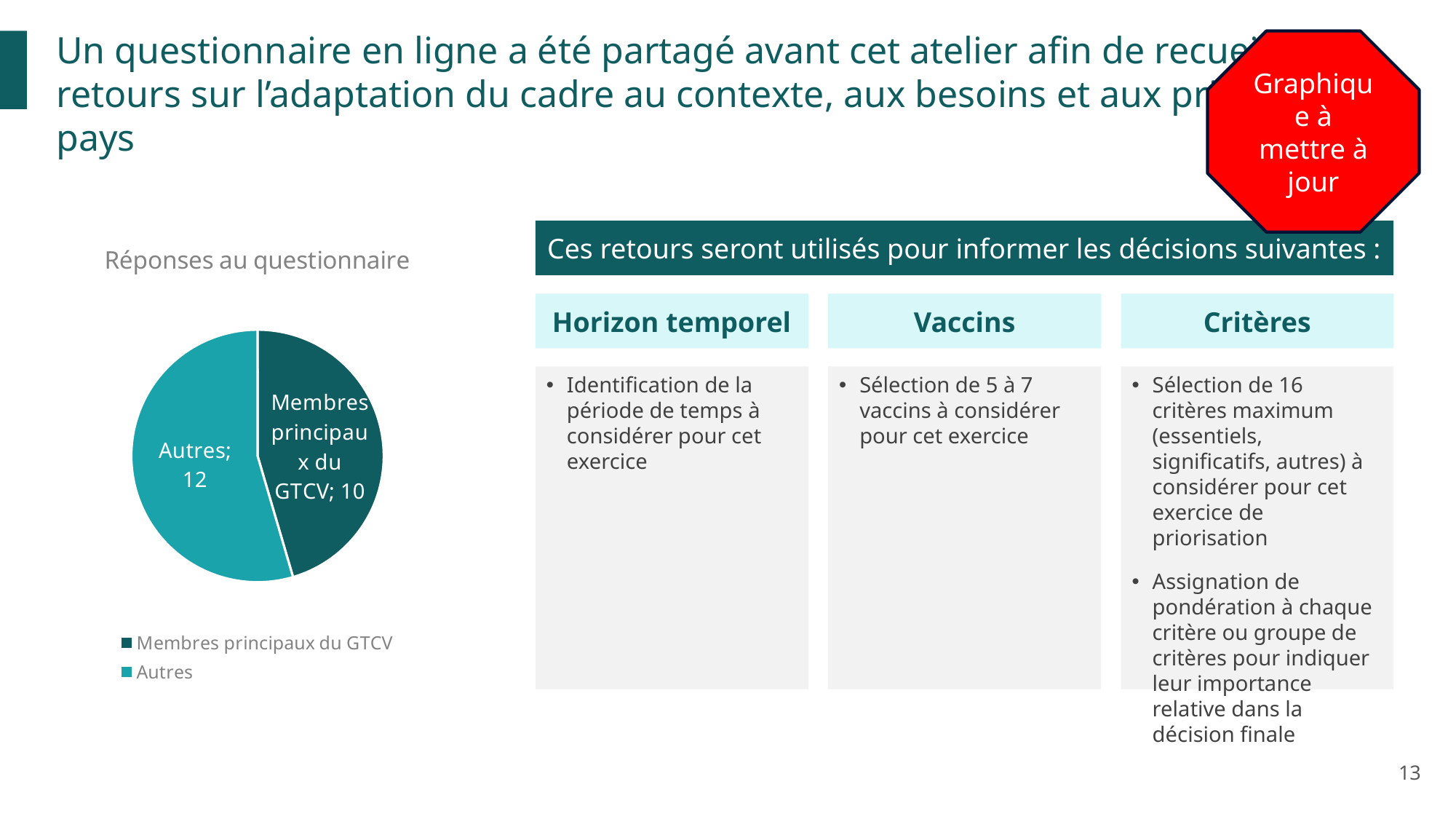
In the pie chart "Réponses au questionnaire", what is the difference between the "Autres" value and the "Membres principaux du GTCV" value? 2 In the pie chart "Réponses au questionnaire", what is the value for "Membres principaux du GTCV"? 10 How many entries does the legend of the pie chart "Réponses au questionnaire" list? 2 In the pie chart "Réponses au questionnaire", which is larger: "Autres" or "Membres principaux du GTCV"? Autres In the pie chart "Réponses au questionnaire", what is the value for "Autres"? 12 What is the total of the two slices in the pie chart "Réponses au questionnaire"? 22 In the pie chart "Réponses au questionnaire", which legend entry is shown in the lighter teal colour? Autres What type of chart is shown under the title "Réponses au questionnaire"? pie chart Which slice of the pie chart "Réponses au questionnaire" is the smallest? Membres principaux du GTCV How many slices does the pie chart "Réponses au questionnaire" have? 2 Which slice of the pie chart "Réponses au questionnaire" is the largest? Autres What is the title of the pie chart on the left of the slide? Réponses au questionnaire